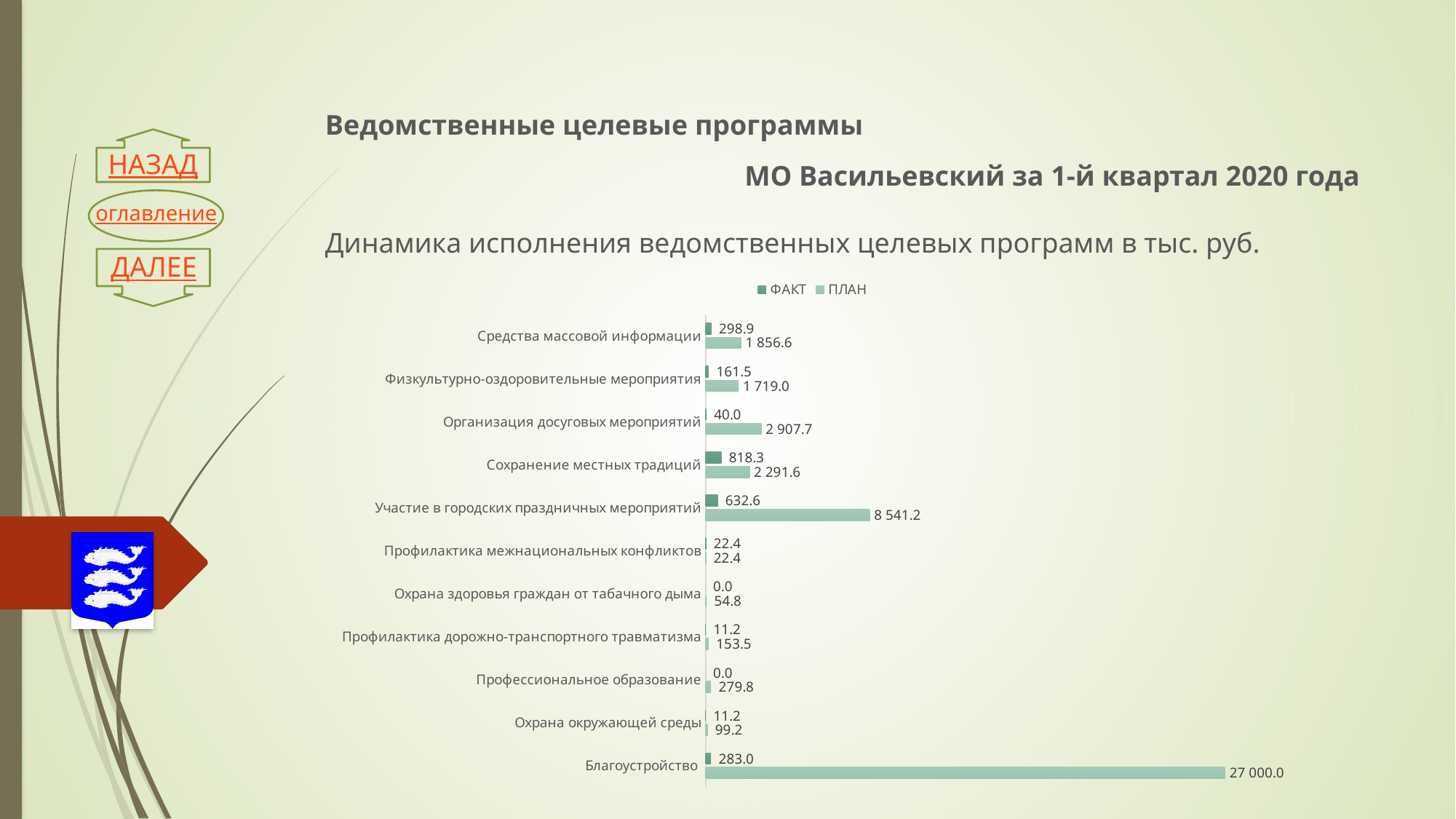
What kind of chart is shown on the slide? Bar chart Which category has the highest ФАКТ value? Сохранение местных традиций What is the difference between the ПЛАН and ФАКТ values for Средства массовой информации? 1 557.7 How many series does the legend list? 2 What is the ФАКТ value for Сохранение местных традиций? 818.3 What is the ПЛАН value for Участие в городских праздничных мероприятий? 8 541.2 How many categories are shown in the chart? 11 What is the ПЛАН value for Благоустройство? 27 000.0 Which is larger for Организация досуговых мероприятий, the ФАКТ value or the ПЛАН value? ПЛАН Which category has the lowest ПЛАН value? Профилактика межнациональных конфликтов What is the ФАКТ value for Профессиональное образование? 0.0 Which category has the highest ПЛАН value? Благоустройство